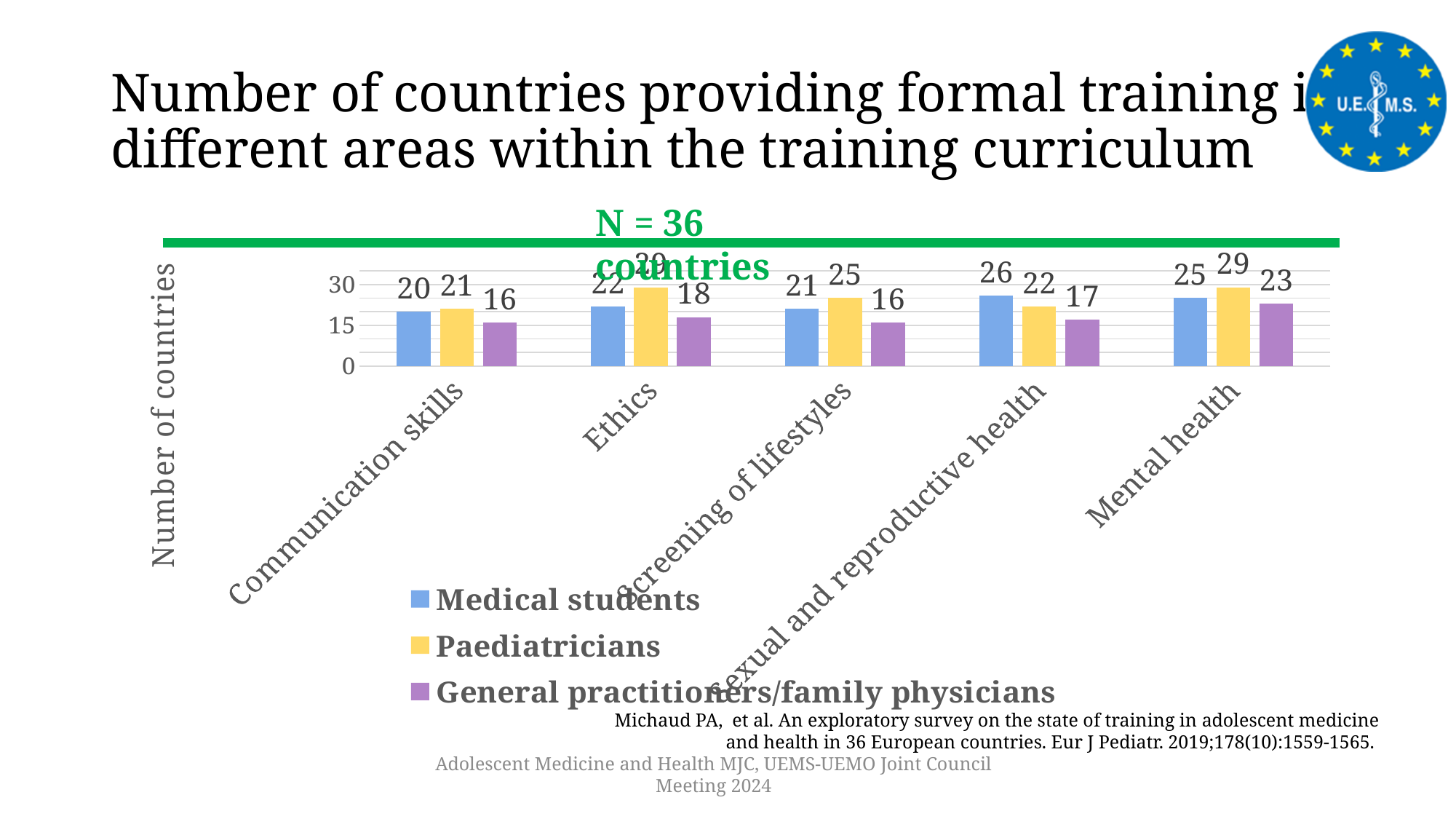
What is the difference between the Paediatricians and General practitioners/family physicians values in Screening of lifestyles? 9 What is the value for Medical students in Communication skills? 20 What is the value for Paediatricians in Screening of lifestyles? 25 What is the label of the y axis? Number of countries What kind of chart is shown on the slide? bar chart What is the value for General practitioners/family physicians in Mental health? 23 What is the value for Medical students in Sexual and reproductive health? 26 How many series does the legend list? 3 Which training area has the lowest value for General practitioners/family physicians? Communication skills and Screening of lifestyles (both 16) In Sexual and reproductive health, which is larger: the value for Medical students or for Paediatricians? Medical students How many training areas (categories) are shown on the x axis? 5 Which training area has the highest value for Medical students? Sexual and reproductive health